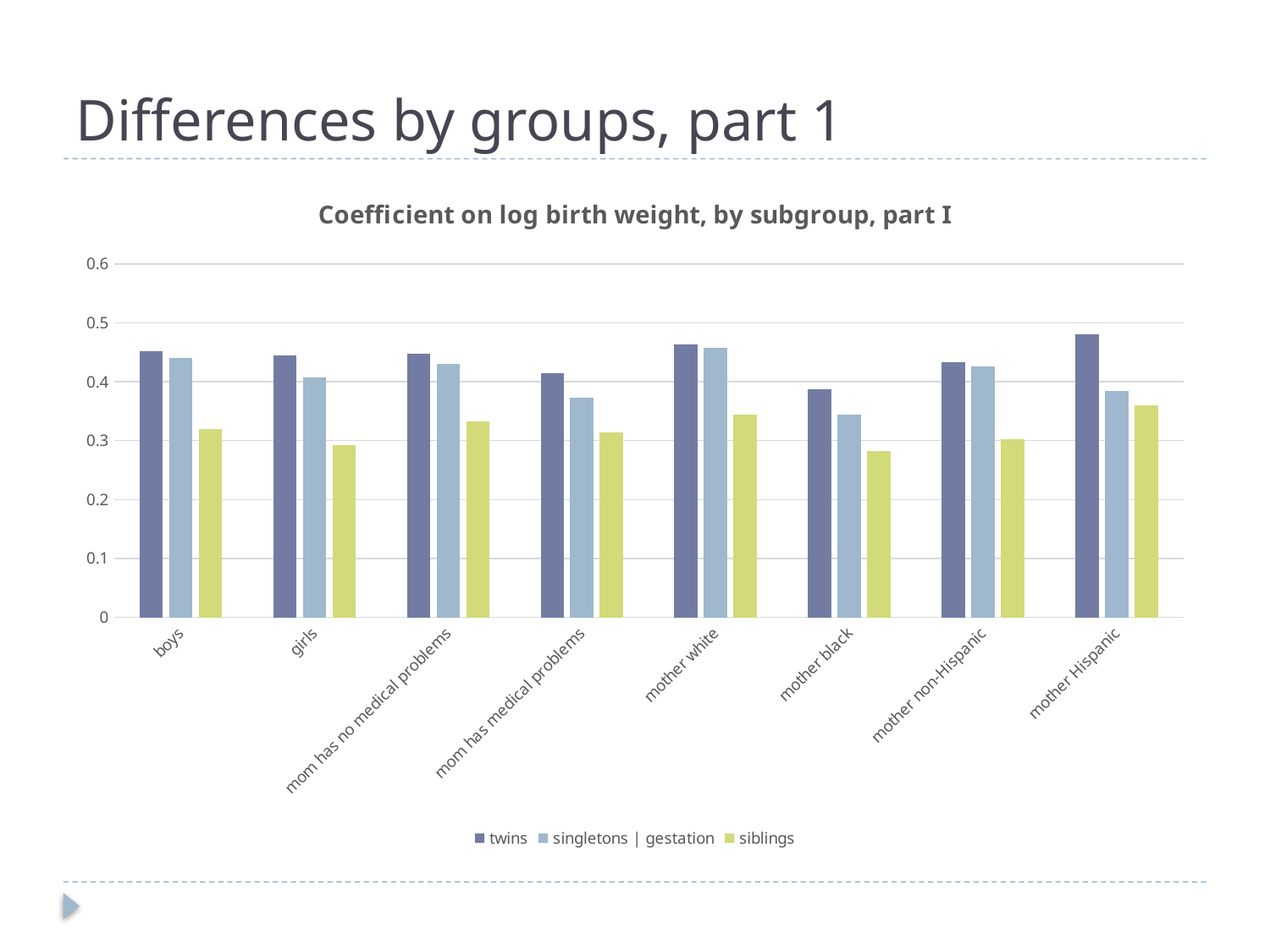
What is the title of the chart? Coefficient on log birth weight, by subgroup, part I How many series does the legend list? 3 Is the twins value for mother black greater or less than 0.4? less Is the siblings value for boys greater or less than 0.3? greater How many subgroup categories are shown on the x axis? 8 Is the singletons | gestation value for mother Hispanic greater or less than 0.4? less Which subgroup has the lowest value for the twins series? mother black What kind of chart is shown on the slide? bar chart Which series is shown in yellow-green? siblings For mother white, which is larger: the twins value or the siblings value? twins For mother black, which is larger: the singletons | gestation value or the siblings value? singletons | gestation Which subgroup has the highest value for the twins series? mother Hispanic